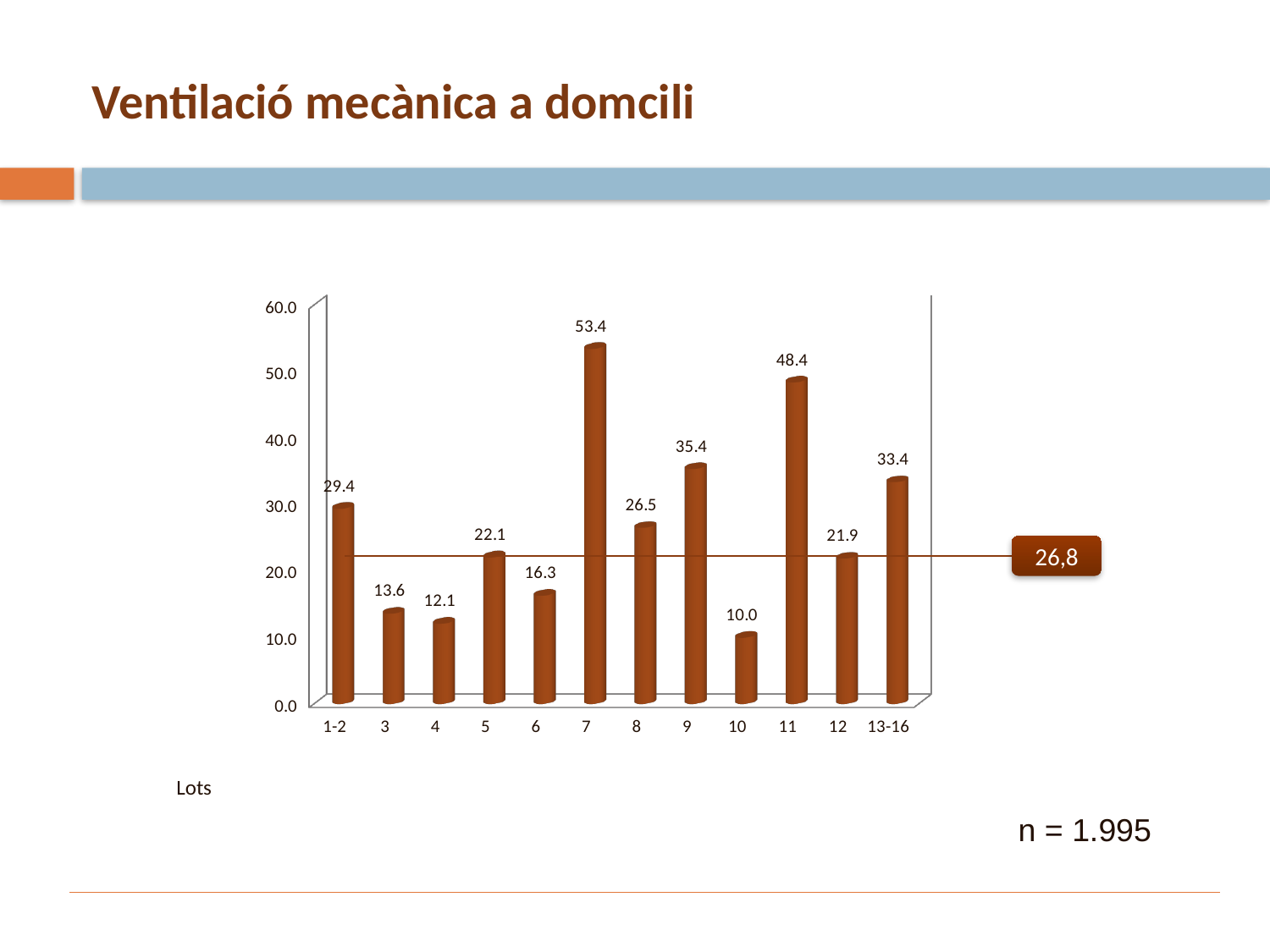
What is the value for lot 13-16? 33.4 Is the value for lot 11 greater or less than 40.0? greater What is the difference between the values for lot 7 and lot 11? 5.0 Which lot has the lowest value? 10 Which lot has the highest value? 7 What is the value for lot 7? 53.4 How many lot categories are shown on the x axis? 12 What is the difference between the values for lot 9 and lot 8? 8.9 What kind of chart is shown on the slide? bar chart Which is larger, the value for lot 5 or the value for lot 6? lot 5 What is the value for lot 1-2? 29.4 What value is shown in the label on the horizontal reference line? 26,8